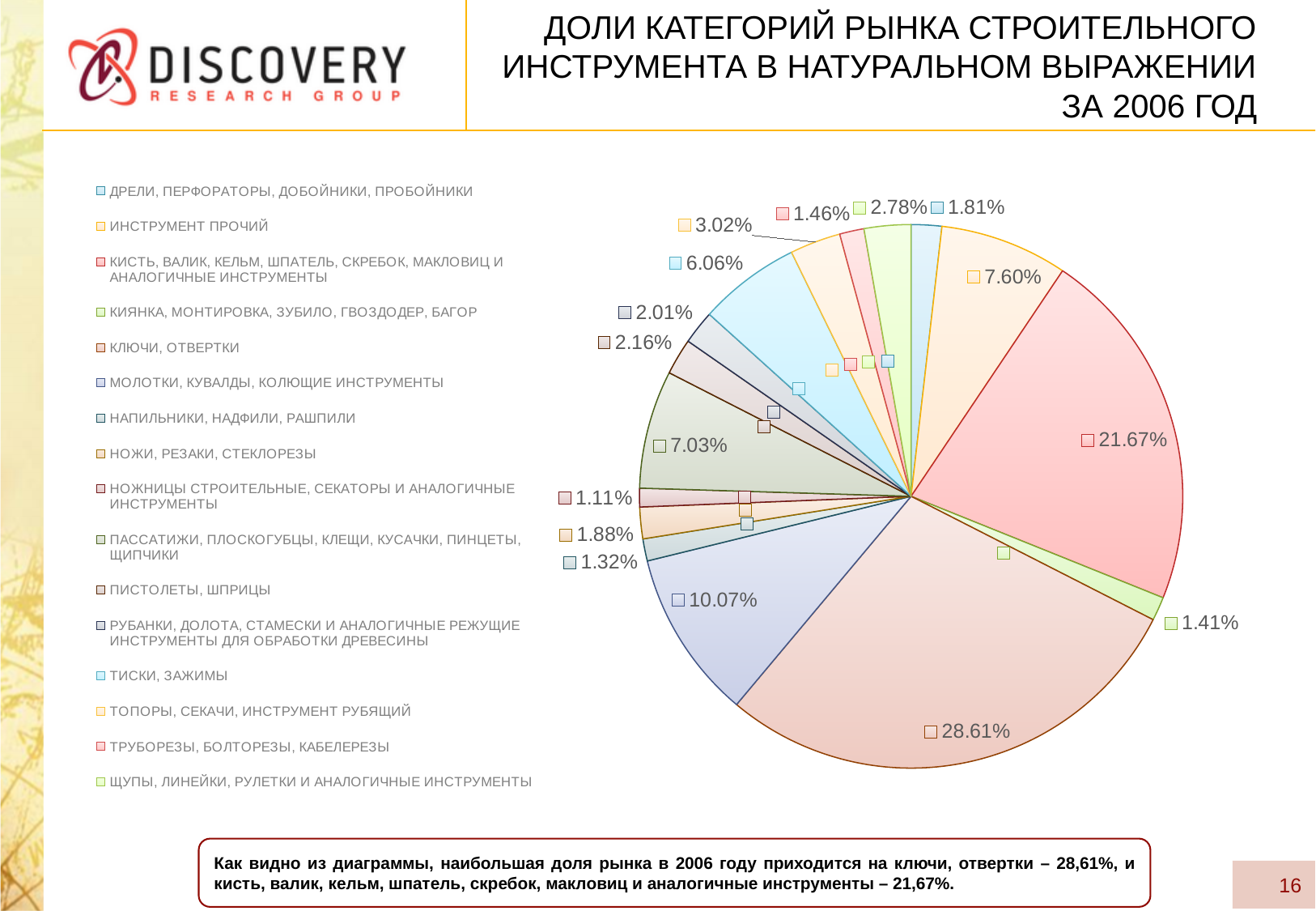
What is the smallest share shown on the pie chart? 1.11% Which category has the largest share of the construction tool market in 2006? КЛЮЧИ, ОТВЕРТКИ How many categories does the legend of the pie chart list? 16 What is the share of the category МОЛОТКИ, КУВАЛДЫ, КОЛЮЩИЕ ИНСТРУМЕНТЫ? 10.07% What is the share of the category КЛЮЧИ, ОТВЕРТКИ? 28.61% Which is larger: the 10.07% slice or the 7.60% slice? 10.07% For which year does the chart show the market category shares? 2006 What kind of chart is shown on the slide? pie chart What is the share of the category ТИСКИ, ЗАЖИМЫ? 6.06% What is the share of the category КИСТЬ, ВАЛИК, КЕЛЬМ, ШПАТЕЛЬ, СКРЕБОК, МАКЛОВИЦ И АНАЛОГИЧНЫЕ ИНСТРУМЕНТЫ? 21.67% What is the difference between the two largest shares, 28.61% and 21.67%? 6.94% What is the combined share of the two largest slices (28.61% and 21.67%)? 50.28%